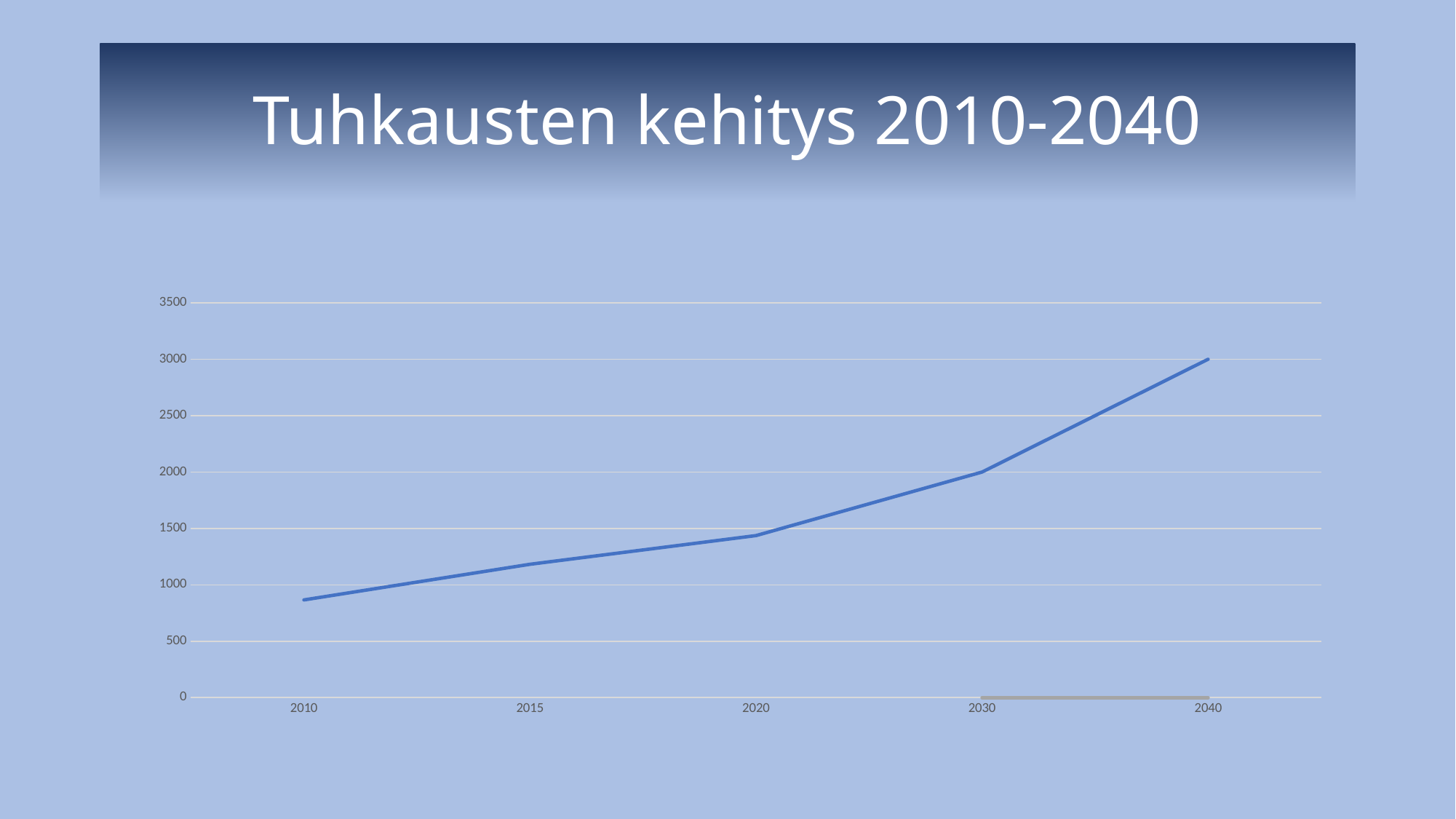
Do the values rise or fall from 2010 to 2040? rise Which year has the highest value? 2040 Is the value for 2010 greater or less than 1000? less Is the value for 2015 greater or less than 1000? greater How many years are plotted along the x axis? 5 What kind of chart is shown on the slide? line chart What value does the line reach in 2040? 3000 Which year has the larger value, 2015 or 2020? 2020 Is the value for 2020 greater or less than 1500? less Which year has the lowest value? 2010 What is the title of the chart on the slide? Tuhkausten kehitys 2010-2040